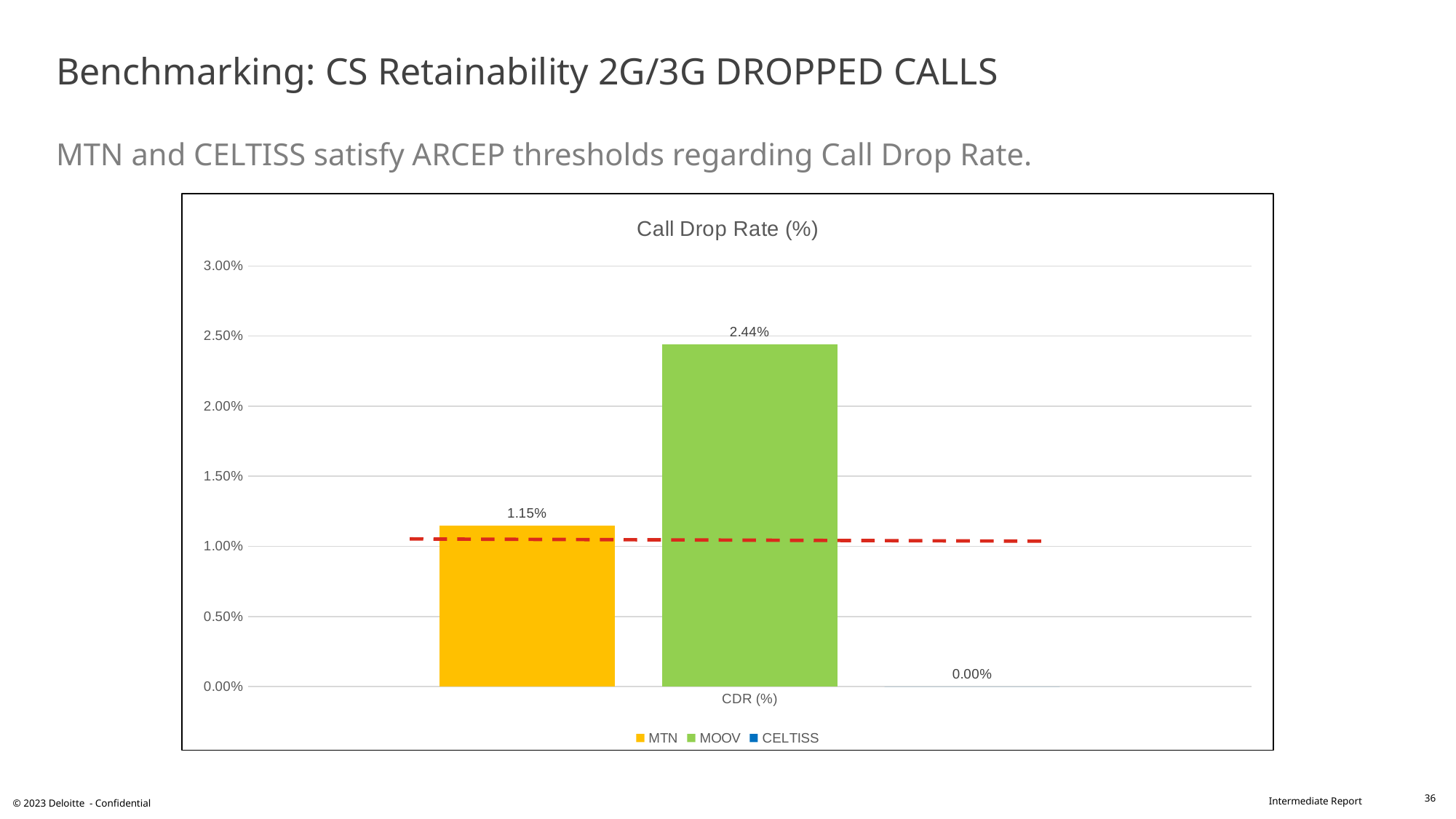
What is the Call Drop Rate for MOOV? 2.44% What is the Call Drop Rate for MTN? 1.15% What is the Call Drop Rate for CELTISS? 0.00% Which operator has the highest Call Drop Rate? MOOV What kind of chart is shown on the slide? Bar chart Which has a higher Call Drop Rate, MTN or MOOV? MOOV What colour is the bar for MOOV? Green What is the title of the chart? Call Drop Rate (%) How many series does the legend list? 3 Which operator has the lowest Call Drop Rate? CELTISS Is the Call Drop Rate for MOOV greater or less than 2.00%? greater What is the difference between the Call Drop Rate of MOOV and MTN? 1.29%